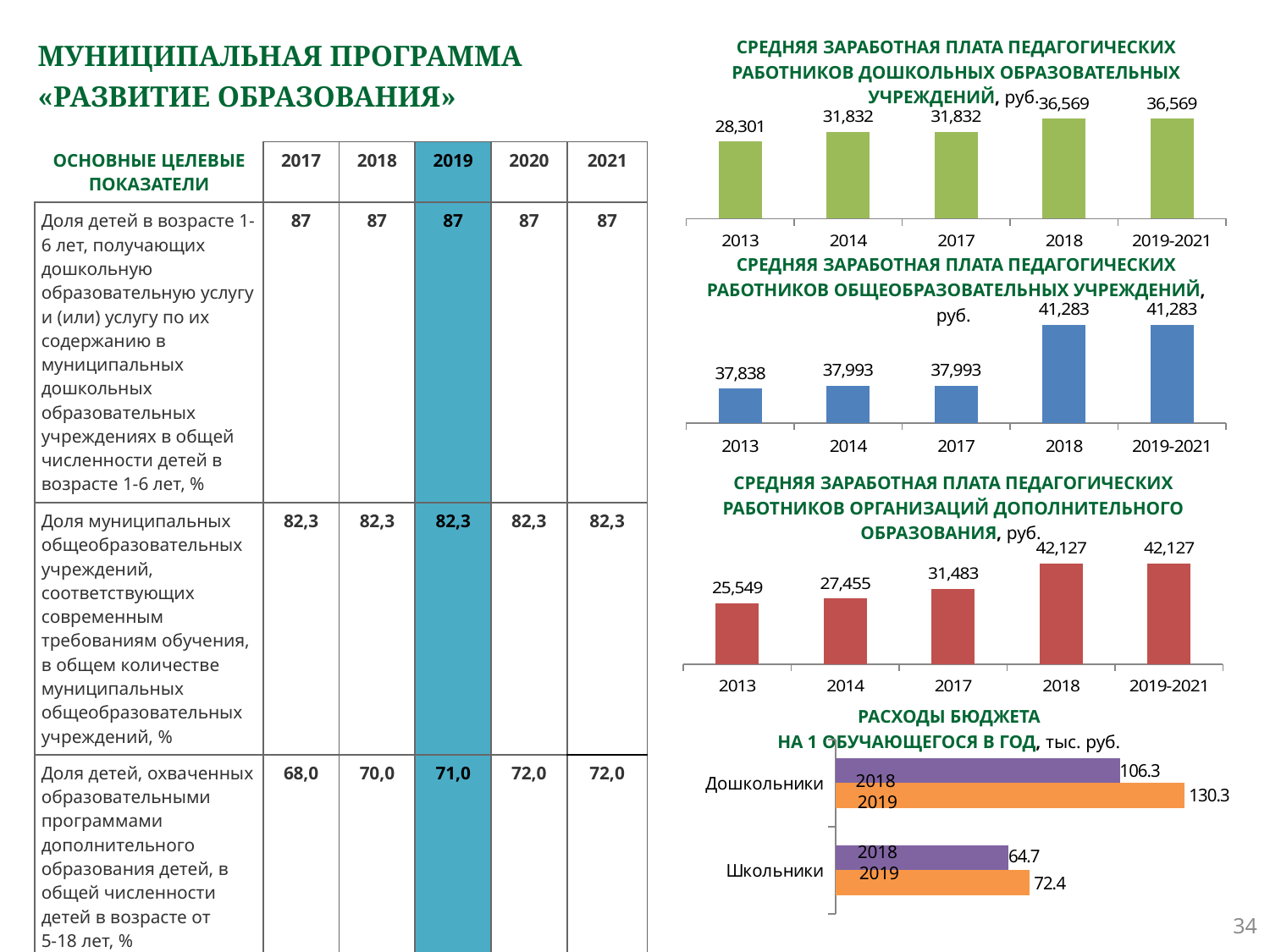
In the chart 'Средняя заработная плата педагогических работников дошкольных образовательных учреждений', what is the value for 2013? 28,301 In the chart 'Средняя заработная плата педагогических работников организаций дополнительного образования', which year has the highest value among 2013, 2014 and 2017? 2017 In the chart 'Расходы бюджета на 1 обучающегося в год', what is the 2019 value for Дошкольники? 130.3 In the chart 'Средняя заработная плата педагогических работников дошкольных образовательных учреждений', what is the difference between the 2018 value and the 2013 value? 8,268 In the chart 'Расходы бюджета на 1 обучающегося в год', which is larger for Школьники: the 2018 value or the 2019 value? 2019 In the chart 'Средняя заработная плата педагогических работников организаций дополнительного образования', what is the difference between the 2018 value and the 2017 value? 10,644 In the chart 'Средняя заработная плата педагогических работников общеобразовательных учреждений', what is the value for 2018? 41,283 In the chart 'Средняя заработная плата педагогических работников дошкольных образовательных учреждений', which year has the lowest value? 2013 In the chart 'Средняя заработная плата педагогических работников общеобразовательных учреждений', do the values rise or fall from 2013 to 2019-2021? rise In the chart 'Средняя заработная плата педагогических работников организаций дополнительного образования', what is the value for 2017? 31,483 In the chart 'Средняя заработная плата педагогических работников общеобразовательных учреждений', how many bars are plotted? 5 What type of chart is 'Расходы бюджета на 1 обучающегося в год'? bar chart